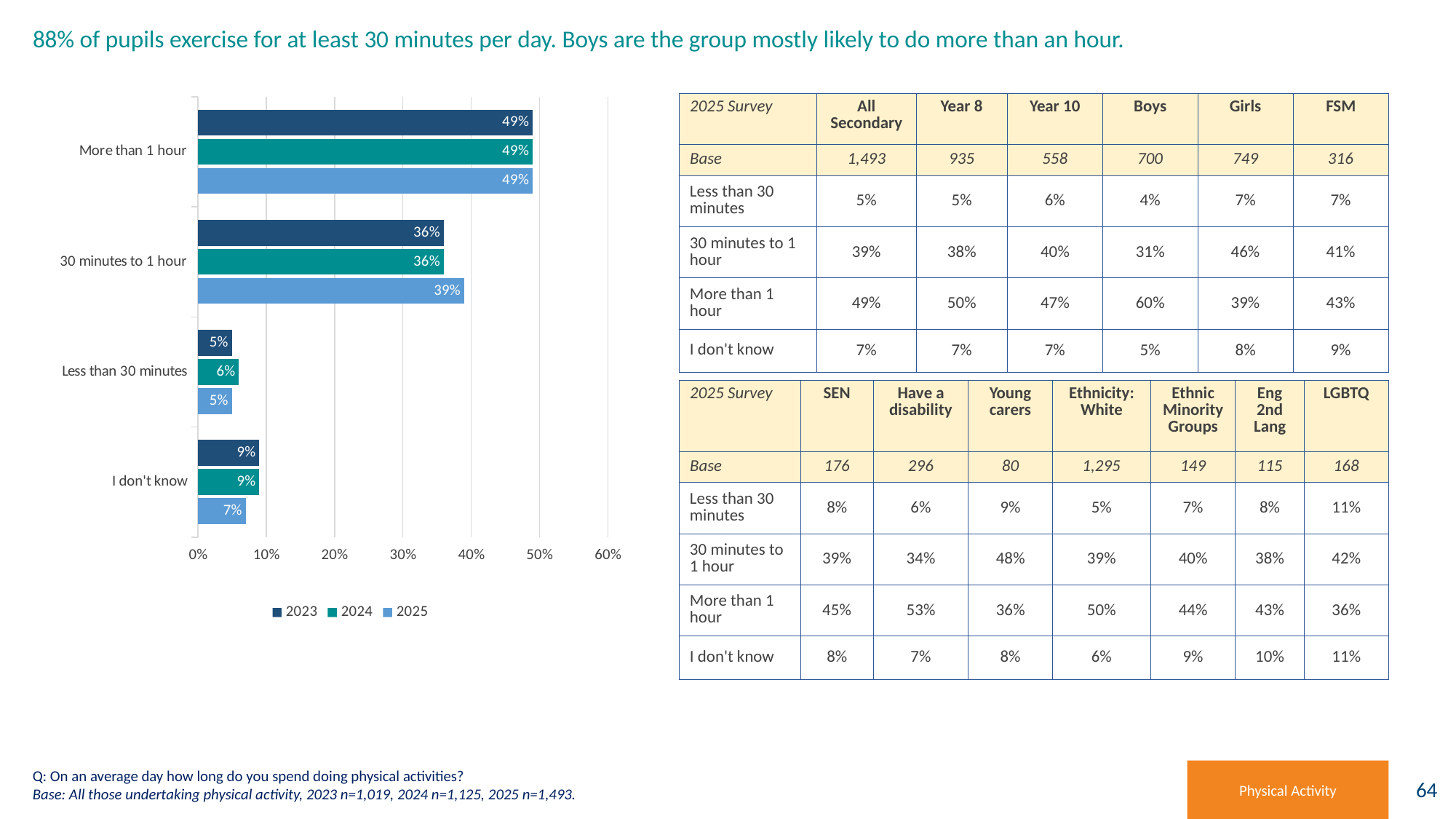
Which category has the highest value in 2025? More than 1 hour How many categories are shown on the chart? 4 What is the value for 'More than 1 hour' in 2025? 49% What is the difference between the 2025 and 2024 values for '30 minutes to 1 hour'? 3 percentage points What is the value for 'I don't know' in 2023? 9% What is the value for 'Less than 30 minutes' in 2024? 6% Is the 2025 value for '30 minutes to 1 hour' greater or less than 30%? greater Which is larger: the 2023 value for 'I don't know' or the 2025 value for 'I don't know'? 2023 What is the value for '30 minutes to 1 hour' in 2025? 39% Which category has the lowest value in 2024? Less than 30 minutes How many series does the legend list? 3 What kind of chart is shown on the slide? Bar chart